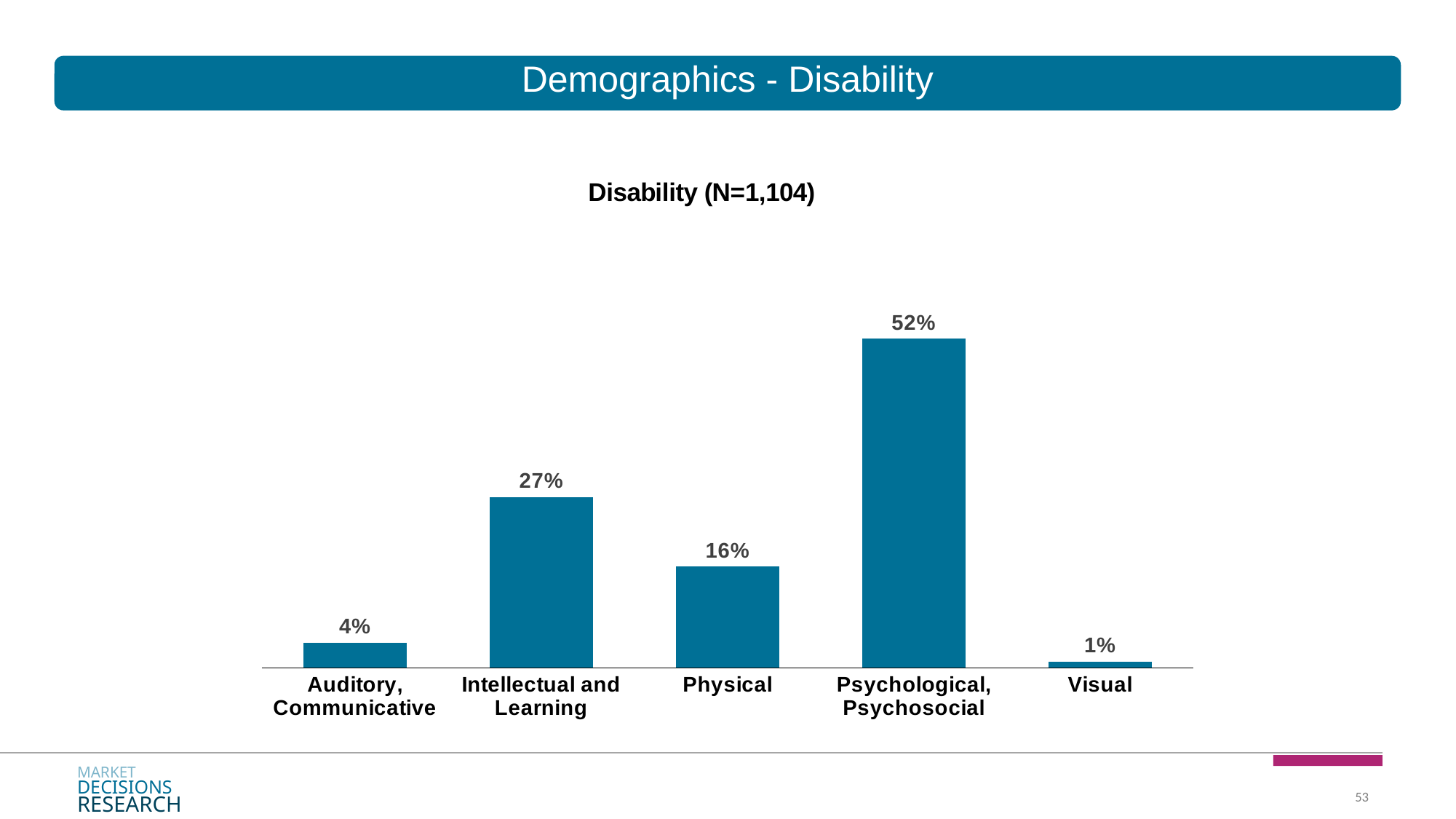
What kind of chart is shown on the slide? Bar chart Which is larger, the value for Physical or the value for Auditory, Communicative? Physical What is the value for Auditory, Communicative? 4% What is the value for Intellectual and Learning? 27% What is the title of the chart? Disability (N=1,104) What is the difference between the values for Psychological, Psychosocial and Intellectual and Learning? 25% Which category has the lowest value? Visual Which category has the highest value? Psychological, Psychosocial How many categories are shown in the chart? 5 What is the value for Visual? 1% What is the value for Physical? 16% What is the value for Psychological, Psychosocial? 52%